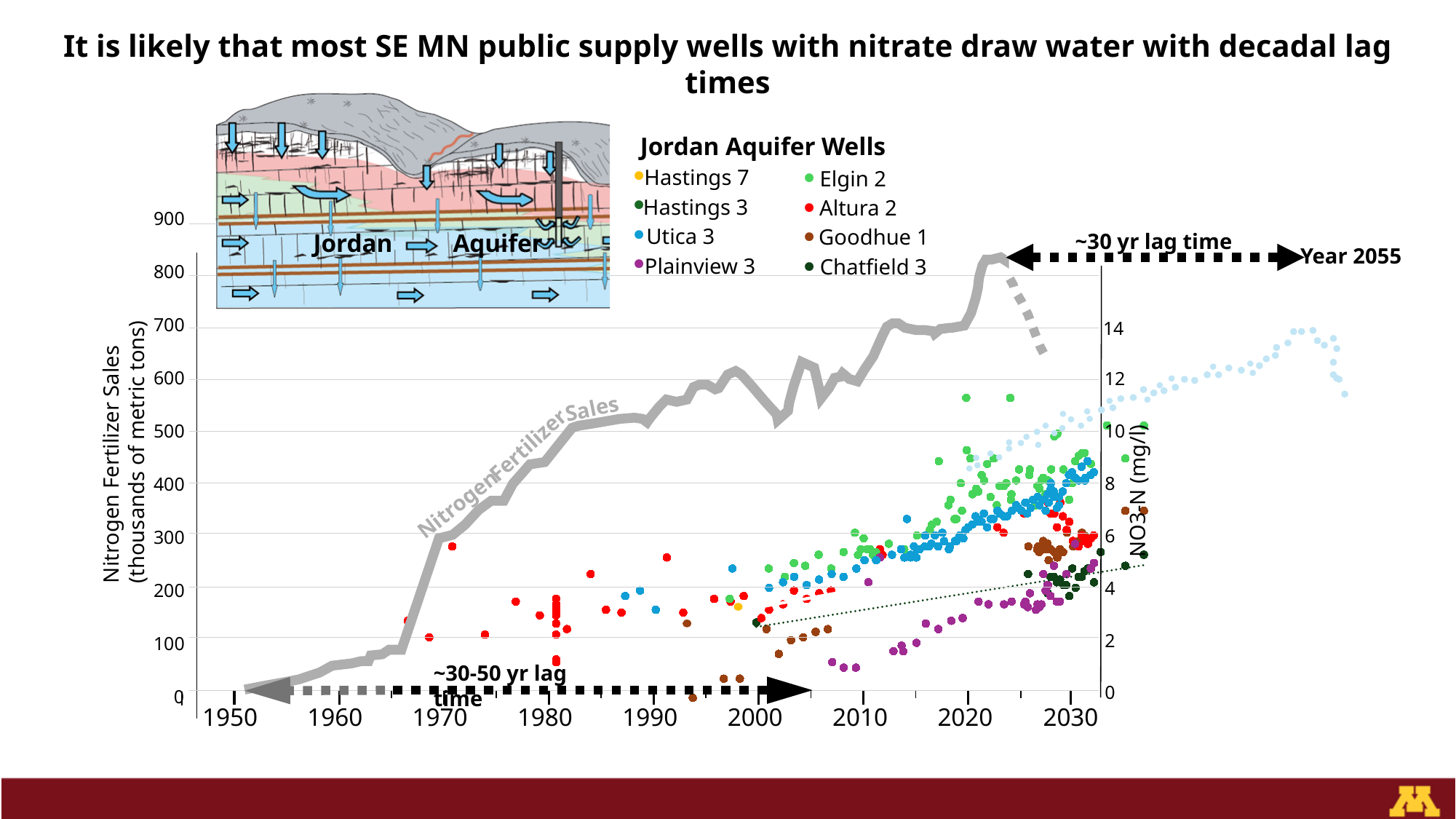
Which well shows the lowest NO3-N values on the chart? Goodhue 1 Do nitrogen fertilizer sales rise or fall from 1950 to 2020? Rise What is the title of the legend listing the wells? Jordan Aquifer Wells What quantity is labelled on the left vertical axis? Nitrogen Fertilizer Sales (thousands of metric tons) Which well shows the highest NO3-N values on the chart? Elgin 2 How many wells are listed in the Jordan Aquifer Wells legend? 8 Is the nitrogen fertilizer sales value in 1990 greater or less than 400 thousand metric tons? greater Is the nitrogen fertilizer sales value in 1950 greater or less than 100 thousand metric tons? less What kind of chart is shown? Line chart with scatter points Around 2020, which well has higher NO3-N, Elgin 2 or Plainview 3? Elgin 2 Is the nitrogen fertilizer sales value in 2020 greater or less than 600 thousand metric tons? greater Do the NO3-N values for Utica 3 rise or fall from 2000 to 2030? Rise